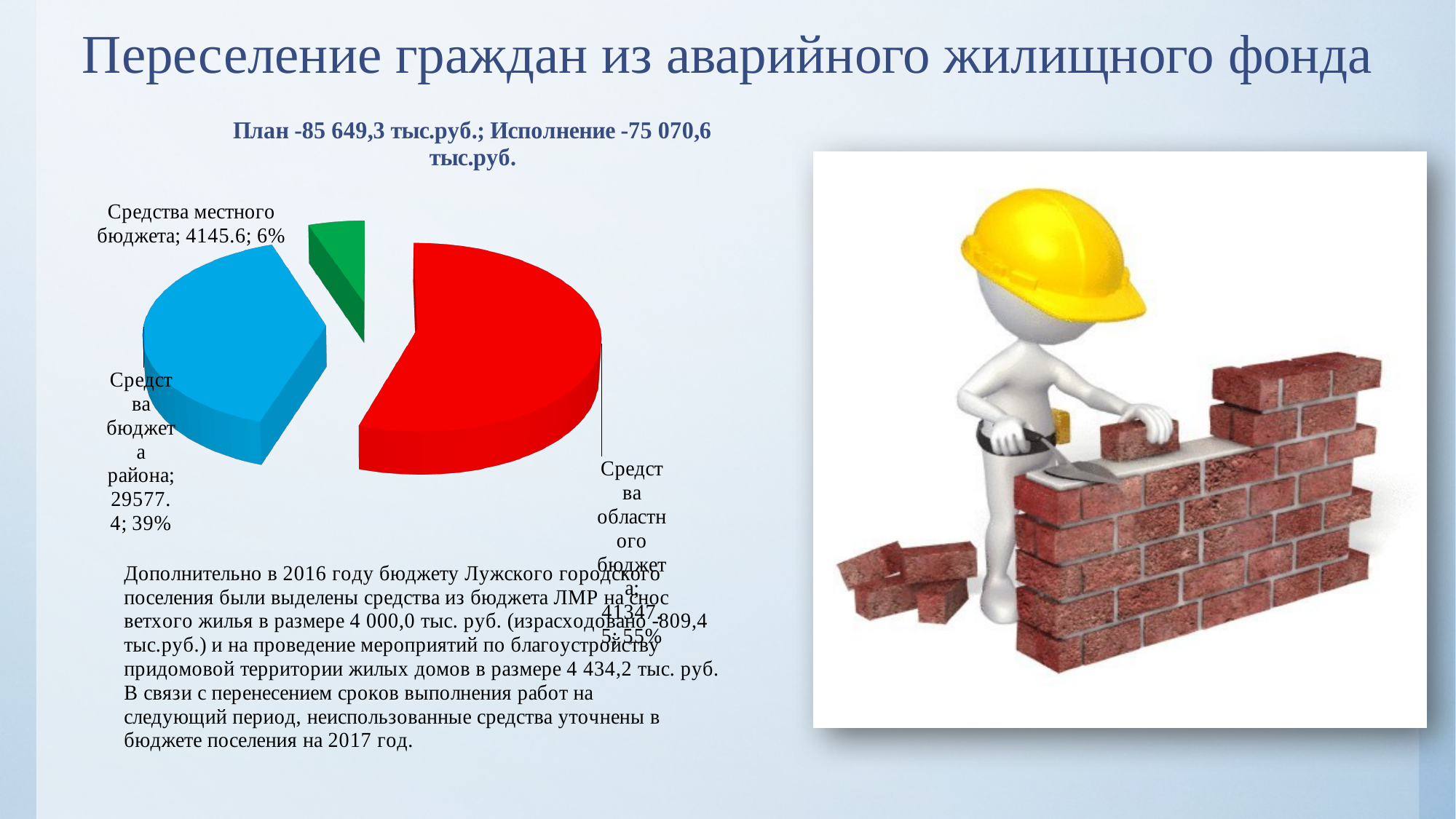
What is the value for Средства областного бюджета in the pie chart? 41347.5 What share of the pie does Средства местного бюджета represent? 6% What colour is the slice for Средства областного бюджета? red Which slice of the pie chart is the largest? Средства областного бюджета Which is larger: Средства бюджета района or Средства местного бюджета? Средства бюджета района What is the value for Средства бюджета района in the pie chart? 29577.4 How many slices does the pie chart have? 3 What kind of chart is shown on the slide? pie chart What share of the pie does Средства бюджета района represent? 39% Which slice of the pie chart is the smallest? Средства местного бюджета What is the value for Средства местного бюджета in the pie chart? 4145.6 What is the difference between the values for Средства областного бюджета and Средства бюджета района? 11770.1